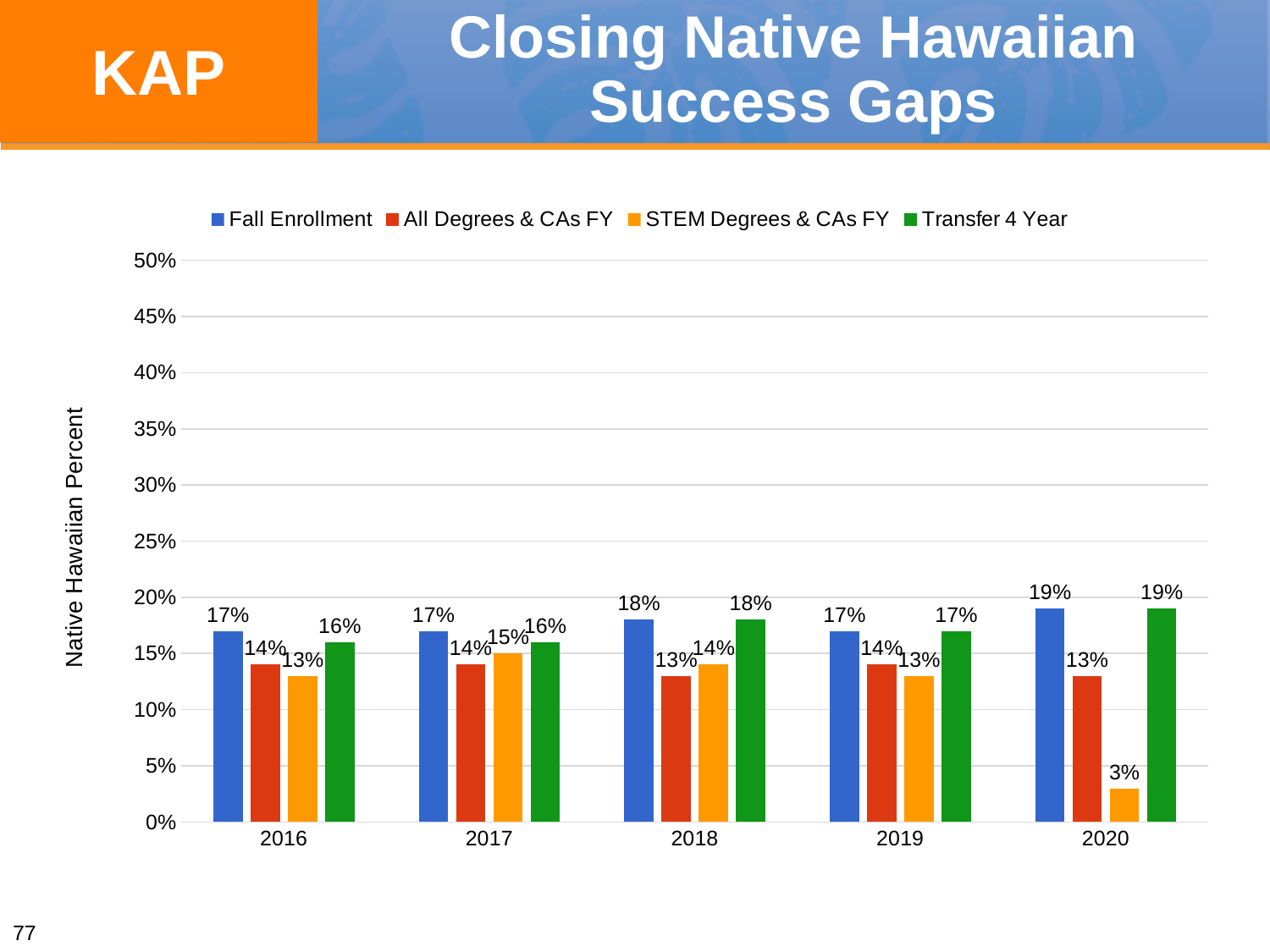
In which year is the STEM Degrees & CAs FY value lowest? 2020 What kind of chart is shown on the slide? Bar chart Which is larger in 2017: the STEM Degrees & CAs FY value or the All Degrees & CAs FY value? STEM Degrees & CAs FY What is the Fall Enrollment value for 2020? 19% What is the difference between the Fall Enrollment value and the STEM Degrees & CAs FY value in 2020? 16% What is the Transfer 4 Year value for 2018? 18% How many series does the legend list? 4 What is the label on the vertical axis? Native Hawaiian Percent What is the STEM Degrees & CAs FY value for 2020? 3% How many years are shown on the x axis? 5 What is the All Degrees & CAs FY value for 2017? 14% In which year is the Transfer 4 Year value highest? 2020